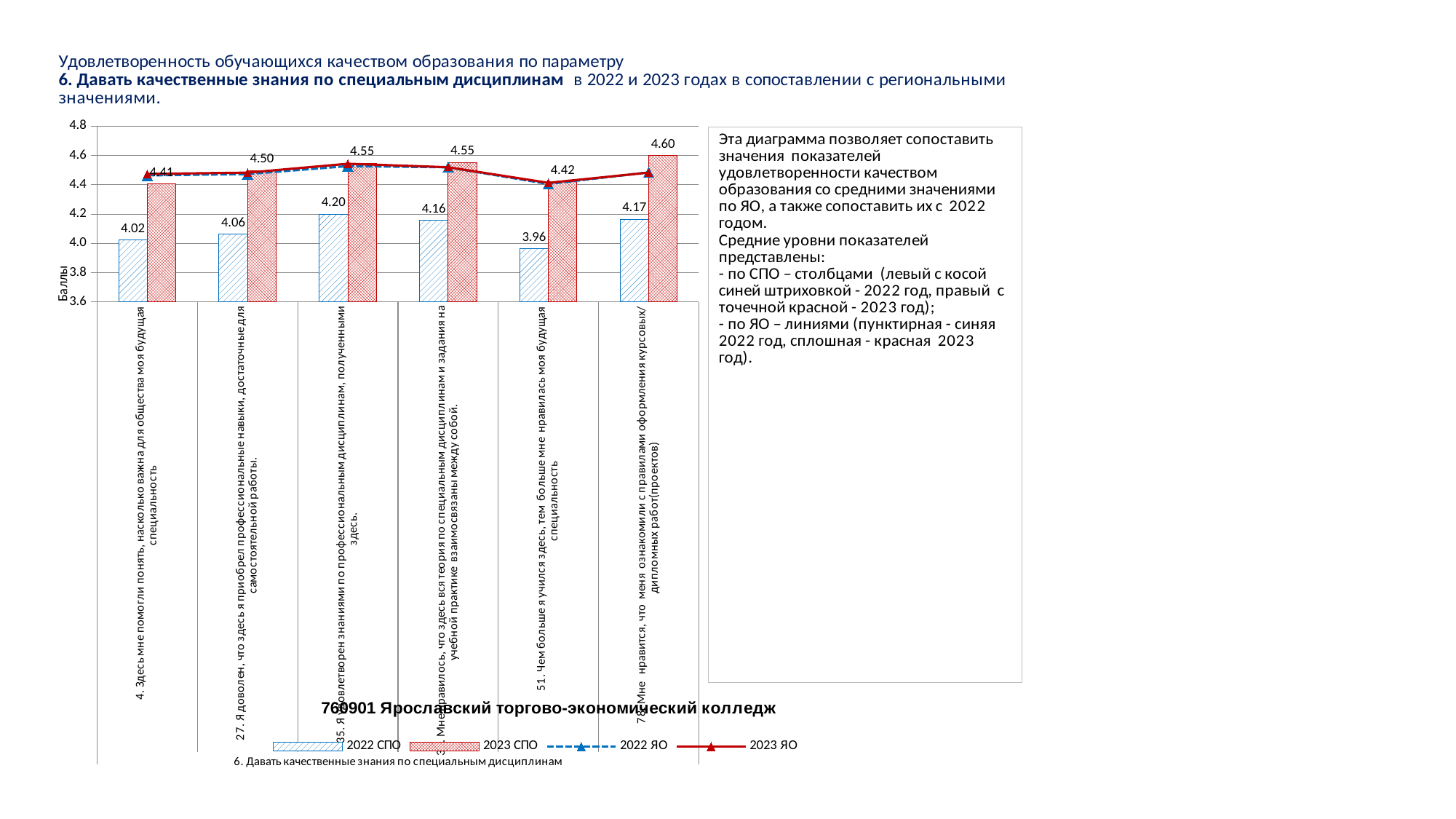
Which category has the highest 2023 СПО value? Мне нравится, что меня ознакомили с правилами оформления курсовых/дипломных работ(проектов) (4.60) What is the 2022 СПО value for the category "4. Здесь мне помогли понять, насколько важна для общества моя будущая специальность"? 4.02 What is the 2023 СПО value for the category "51. Чем больше я учился здесь, тем больше мне нравилась моя будущая специальность"? 4.42 Is the 2023 ЯО line value for the category "27. Я доволен, что здесь я приобрел профессиональные навыки, достаточные для самостоятельной работы" greater or less than 4.2? greater For the category "27. Я доволен, что здесь я приобрел профессиональные навыки, достаточные для самостоятельной работы", what is the difference between the 2023 СПО and 2022 СПО values? 0.44 How many series does the chart legend list? 4 Which has the larger 2022 СПО value: category 35 (Я удовлетворен знаниями по профессиональным дисциплинам) or category 27 (Я доволен, что здесь я приобрел профессиональные навыки)? Category 35 What is the label of the vertical axis of the chart? Баллы For the category "4. Здесь мне помогли понять, насколько важна для общества моя будущая специальность", how much higher is the 2023 СПО value than the 2022 СПО value? 0.39 What is the 2023 СПО value for the category "35. Я удовлетворен знаниями по профессиональным дисциплинам, полученным здесь"? 4.55 Which category has the lowest 2022 СПО value? 51. Чем больше я учился здесь, тем больше мне нравилась моя будущая специальность (3.96) How many categories (survey statements) are shown on the x axis of the chart? 6